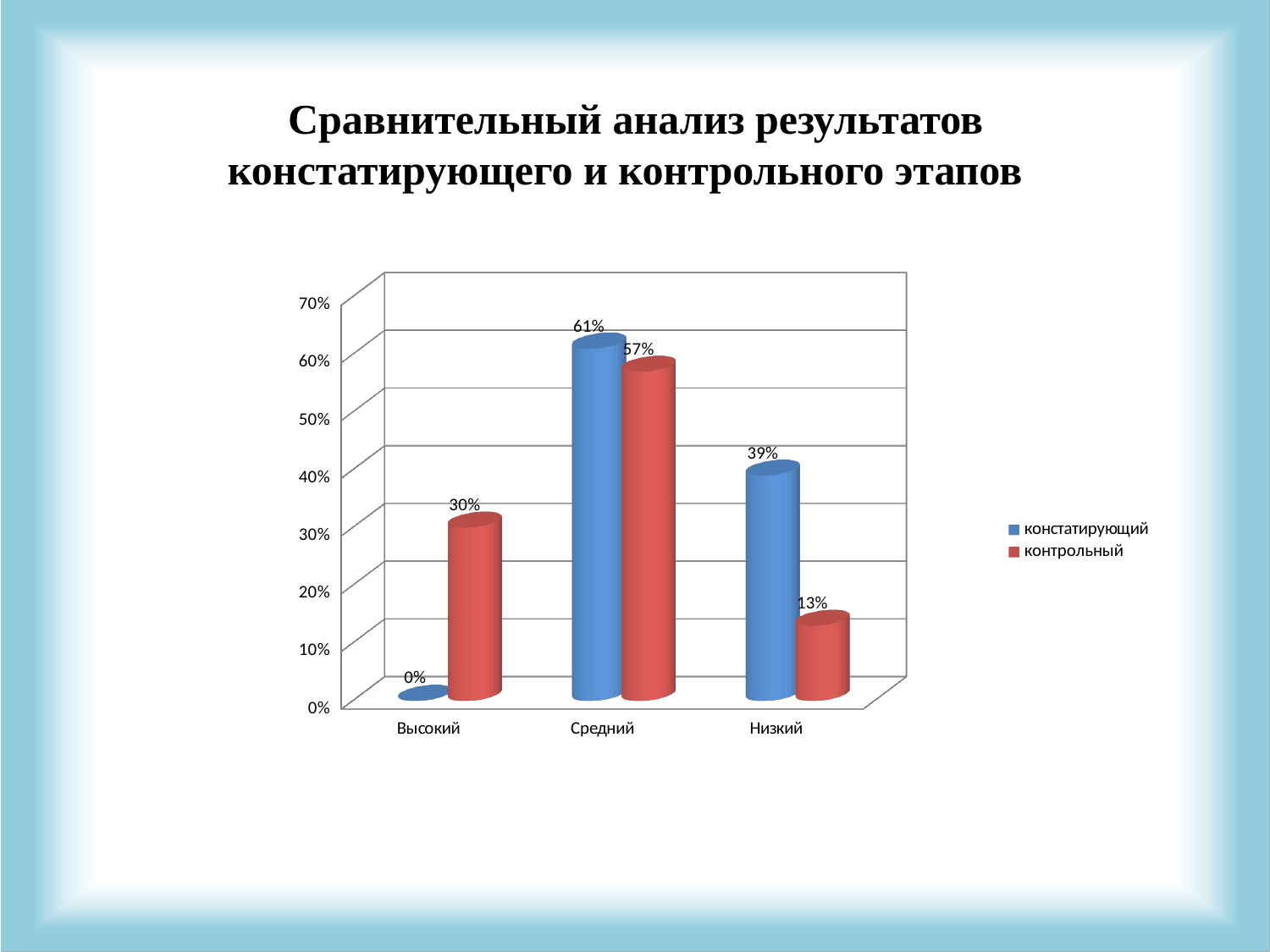
Which category has the lowest value in the констатирующий series? Высокий How many categories are shown on the x axis? 3 What kind of chart is shown on the slide? bar chart Which is larger for Средний: the констатирующий value or the контрольный value? констатирующий What is the value for Средний in the констатирующий series? 61% What is the value for Высокий in the констатирующий series? 0% What is the value for Низкий in the контрольный series? 13% How many series does the legend list? 2 Which category has the highest value in the контрольный series? Средний What is the difference between the констатирующий and контрольный values for Низкий? 26% What colour are the bars for the контрольный series? red What is the value for Высокий in the контрольный series? 30%